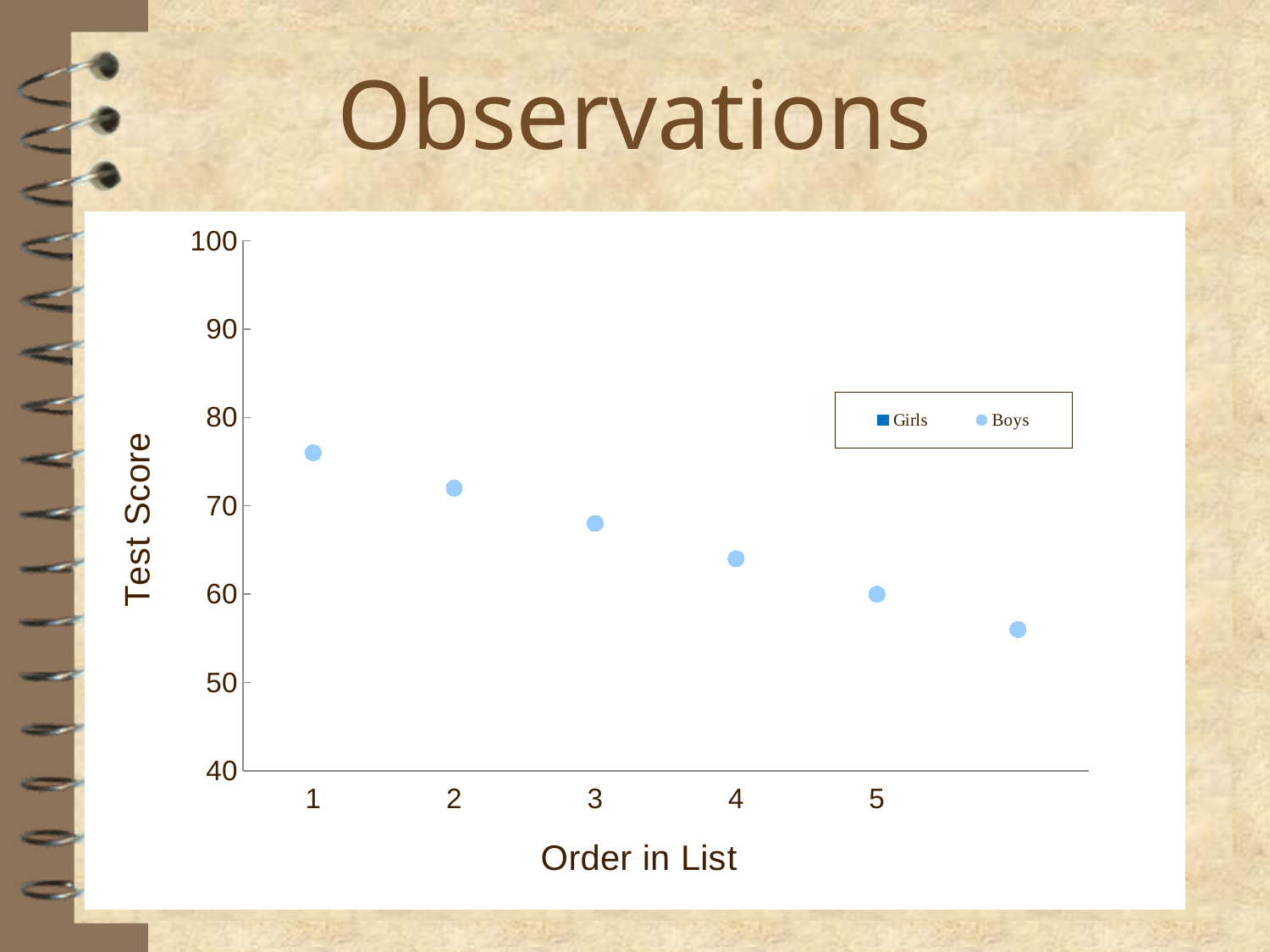
At which order in list is the Boys test score highest? 1 Is the Boys test score at order 4 greater or less than 60? greater What is the label on the vertical axis of the chart? Test Score How many series does the legend list? 2 How many Boys points are plotted on the chart? 6 What is the label on the horizontal axis of the chart? Order in List Which has the larger Boys test score, order 1 or order 4? order 1 Do the Boys test scores rise or fall as the order in list increases? fall What kind of chart is shown on the slide? scatter chart Is the Boys test score at order 1 greater or less than 70? greater Is the Boys test score at order 2 greater or less than 80? less